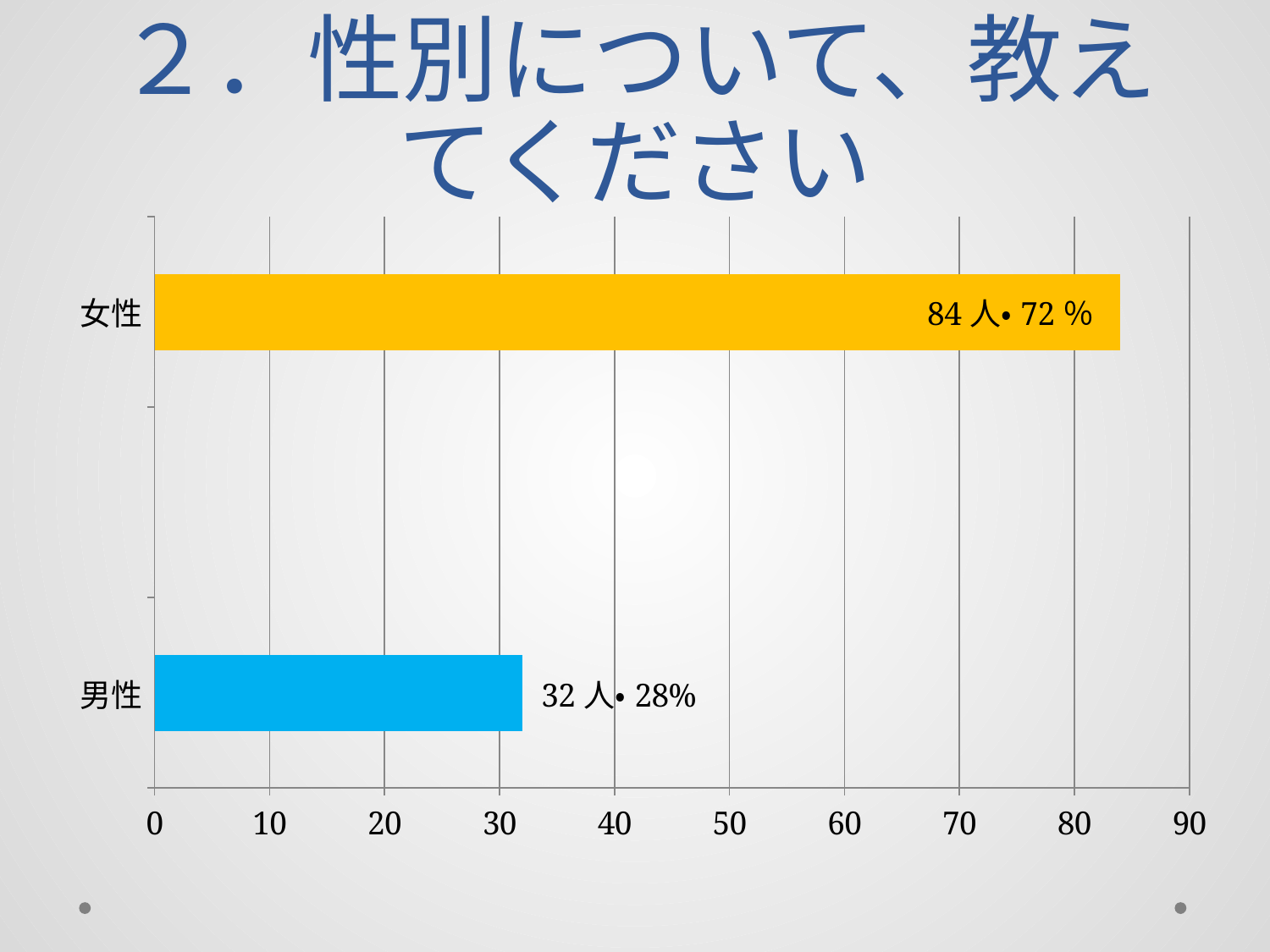
Which category has the lowest value? 男性 How many people are in the 男性 category? 32 人 How many people are in the 女性 category? 84 人 How many categories are shown in the chart? 2 What is the difference in number of people between 女性 and 男性? 52 人 What colour is the 男性 bar? blue What percentage does the 女性 bar represent? 72 % What kind of chart is shown on the slide? bar chart Which category has the highest value? 女性 What percentage does the 男性 bar represent? 28% Which is larger, the value for 女性 or the value for 男性? 女性 Is the value for 女性 greater or less than 80? greater